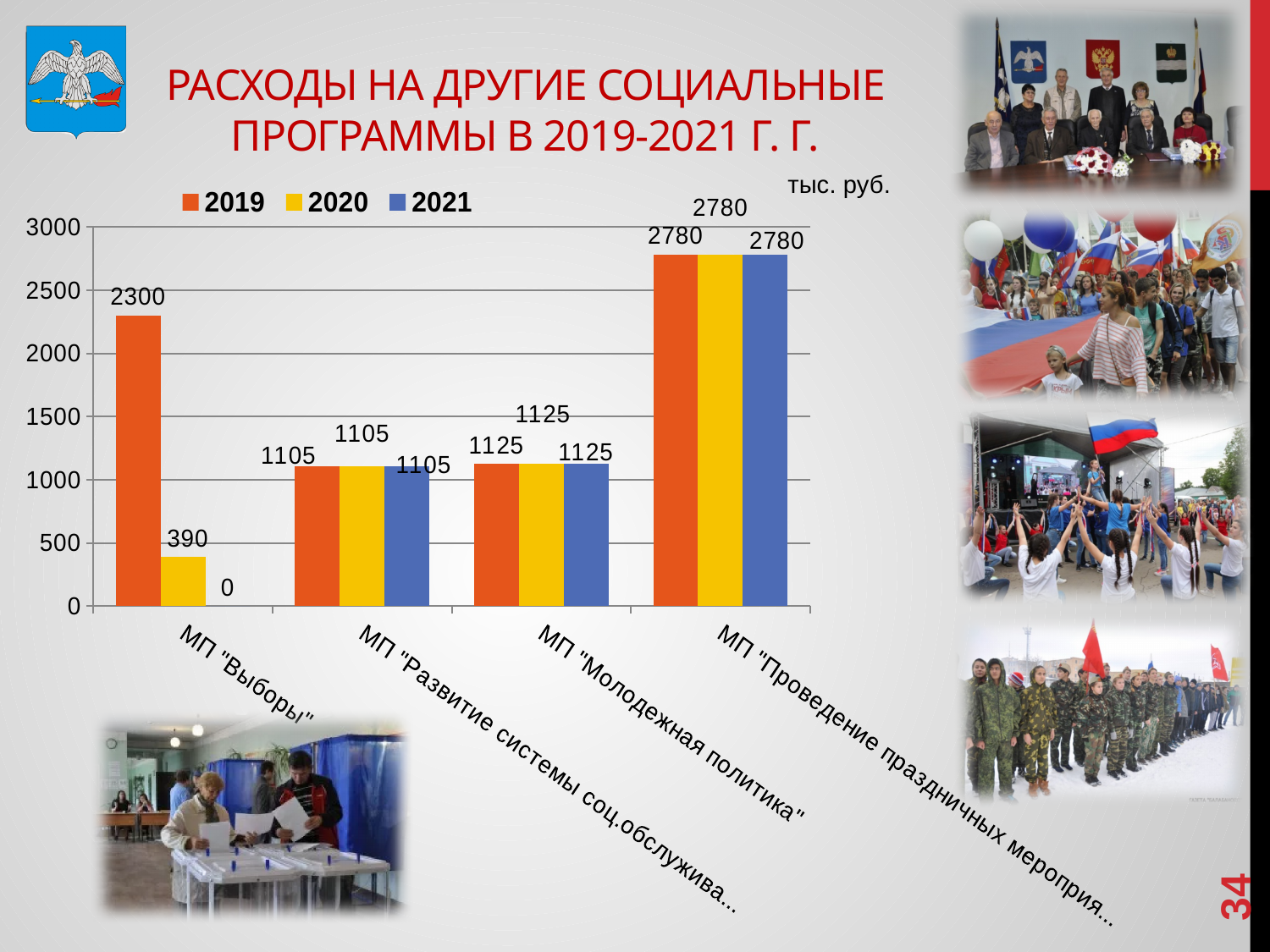
How many series does the legend list? 3 What is the value for МП "Выборы" in 2019? 2300 What is the value for МП "Выборы" in 2021? 0 What is the value for МП "Развитие системы соц.обслужива..." in 2020? 1105 What is the value for МП "Молодежная политика" in 2021? 1125 Which category has the highest value in 2020? МП "Проведение праздничных мероприя..." Which category has the lowest value in 2021? МП "Выборы" Which is larger: the 2019 value for МП "Выборы" or the 2019 value for МП "Проведение праздничных мероприя..."? МП "Проведение праздничных мероприя..." How many categories are shown on the x axis? 4 What is the difference between the 2019 and 2020 values for МП "Выборы"? 1910 What kind of chart is shown on the slide? Bar chart What is the value for МП "Выборы" in 2020? 390